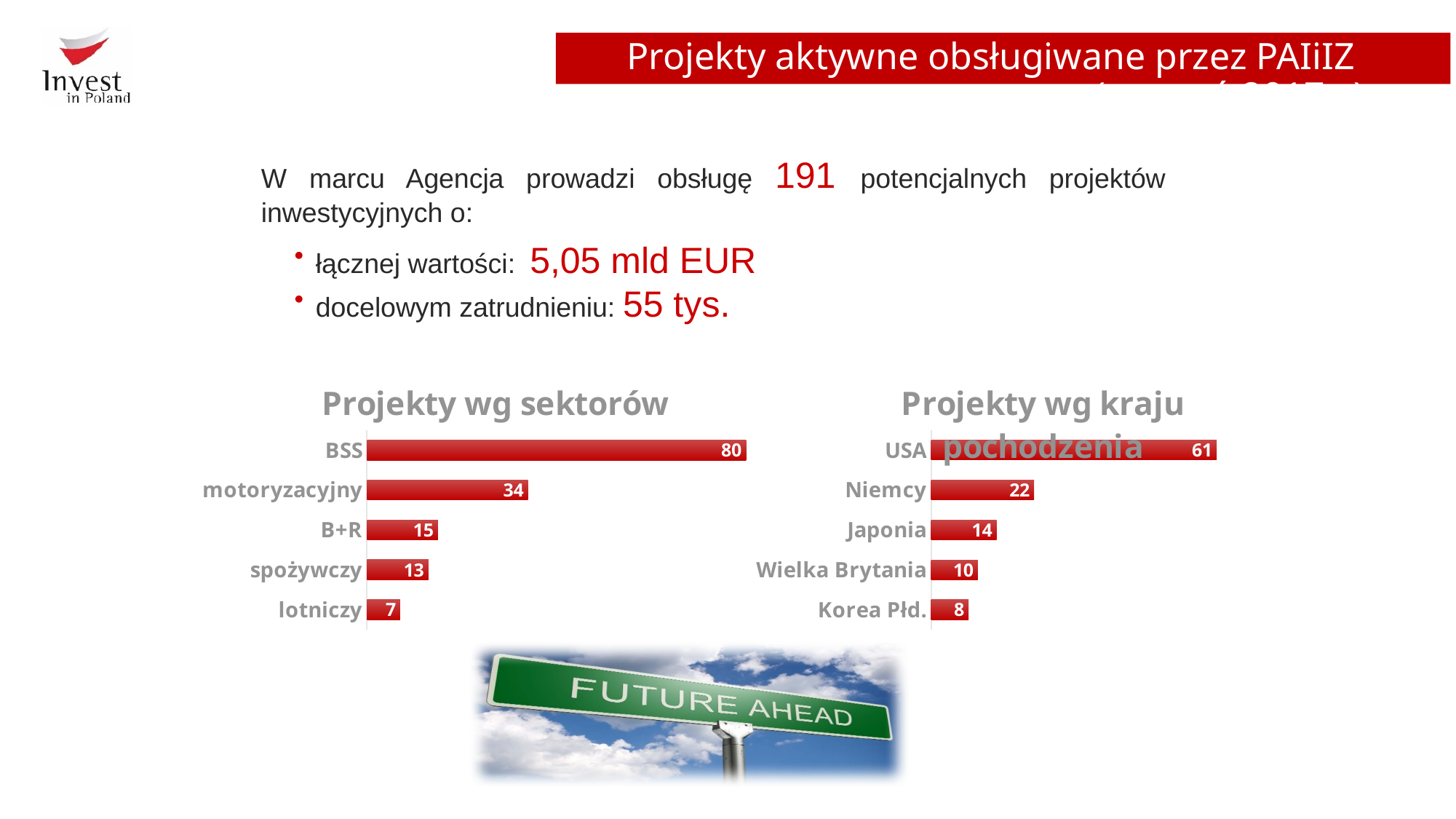
In the 'Projekty wg kraju pochodzenia' chart, what is the value for USA? 61 In the 'Projekty wg kraju pochodzenia' chart, which country has the highest value? USA In the 'Projekty wg kraju pochodzenia' chart, what is the difference between Niemcy and Japonia? 8 In the 'Projekty wg kraju pochodzenia' chart, what is the value for Wielka Brytania? 10 In the 'Projekty wg sektorów' chart, what is the difference between BSS and motoryzacyjny? 46 In the 'Projekty wg sektorów' chart, which sector has the lowest value? lotniczy In the 'Projekty wg sektorów' chart, which is larger, B+R or spożywczy? B+R In the 'Projekty wg kraju pochodzenia' chart, how many countries are shown? 5 In the 'Projekty wg sektorów' chart, what is the value for BSS? 80 What type of chart is the 'Projekty wg kraju pochodzenia' chart? bar chart In the 'Projekty wg sektorów' chart, how many sectors are shown? 5 In the 'Projekty wg sektorów' chart, what is the value for motoryzacyjny? 34